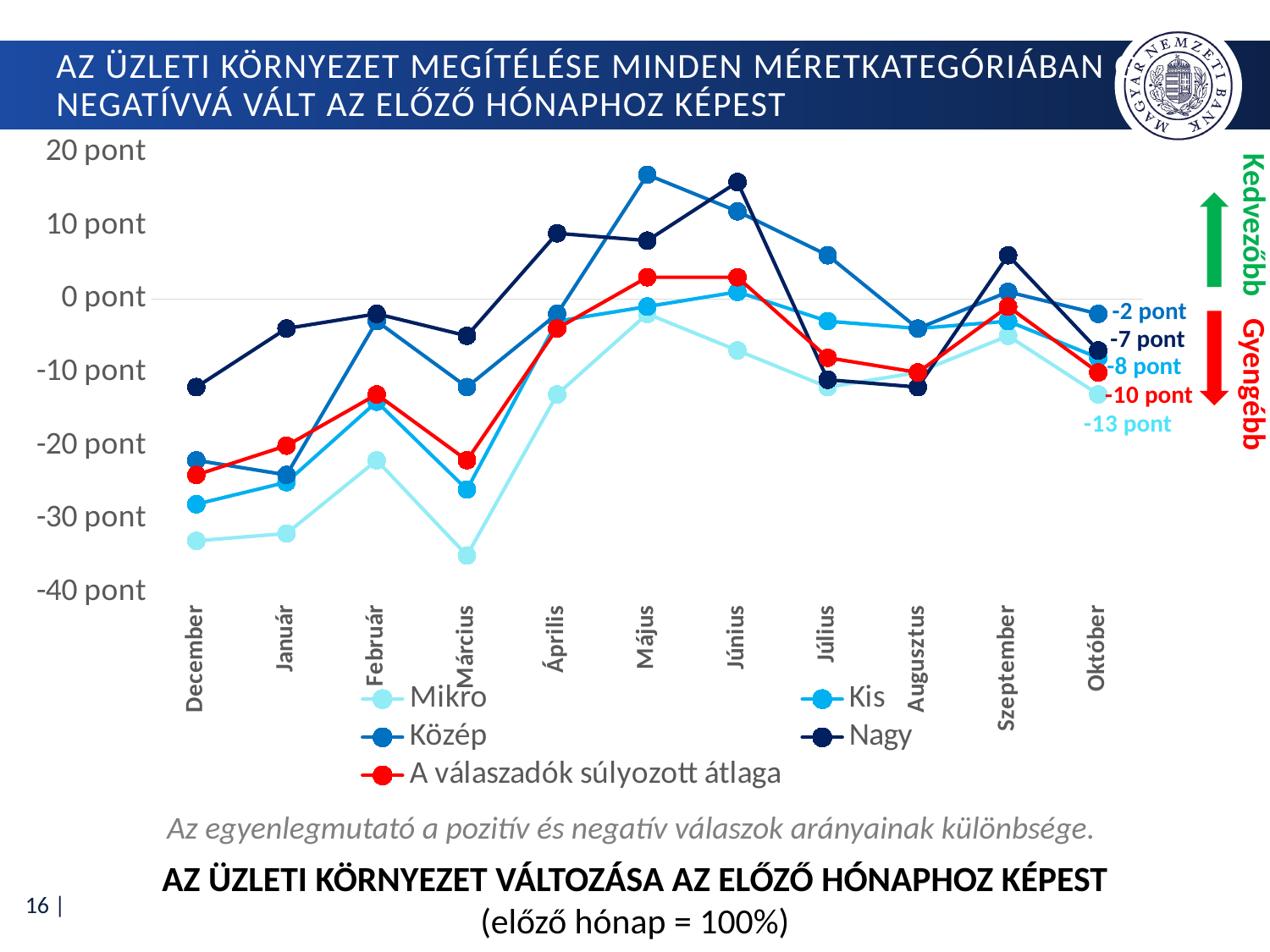
What is the difference between the Közép and Mikro values in Október? 11 pont Is the value for Közép in Május greater or less than 10 pont? greater In Október, which is larger: the value for Nagy or the value for Kis? Nagy How many months are shown along the x axis? 11 How many series does the legend list? 5 What is the value for Közép in Október? -2 pont Which series has the lowest value in Október? Mikro What kind of chart is shown on the slide? line chart Does the Mikro series rise or fall from Március to Május? rise Which series has the highest value in Október? Közép What is the value for Mikro in Október? -13 pont What is the value for A válaszadók súlyozott átlaga in Október? -10 pont